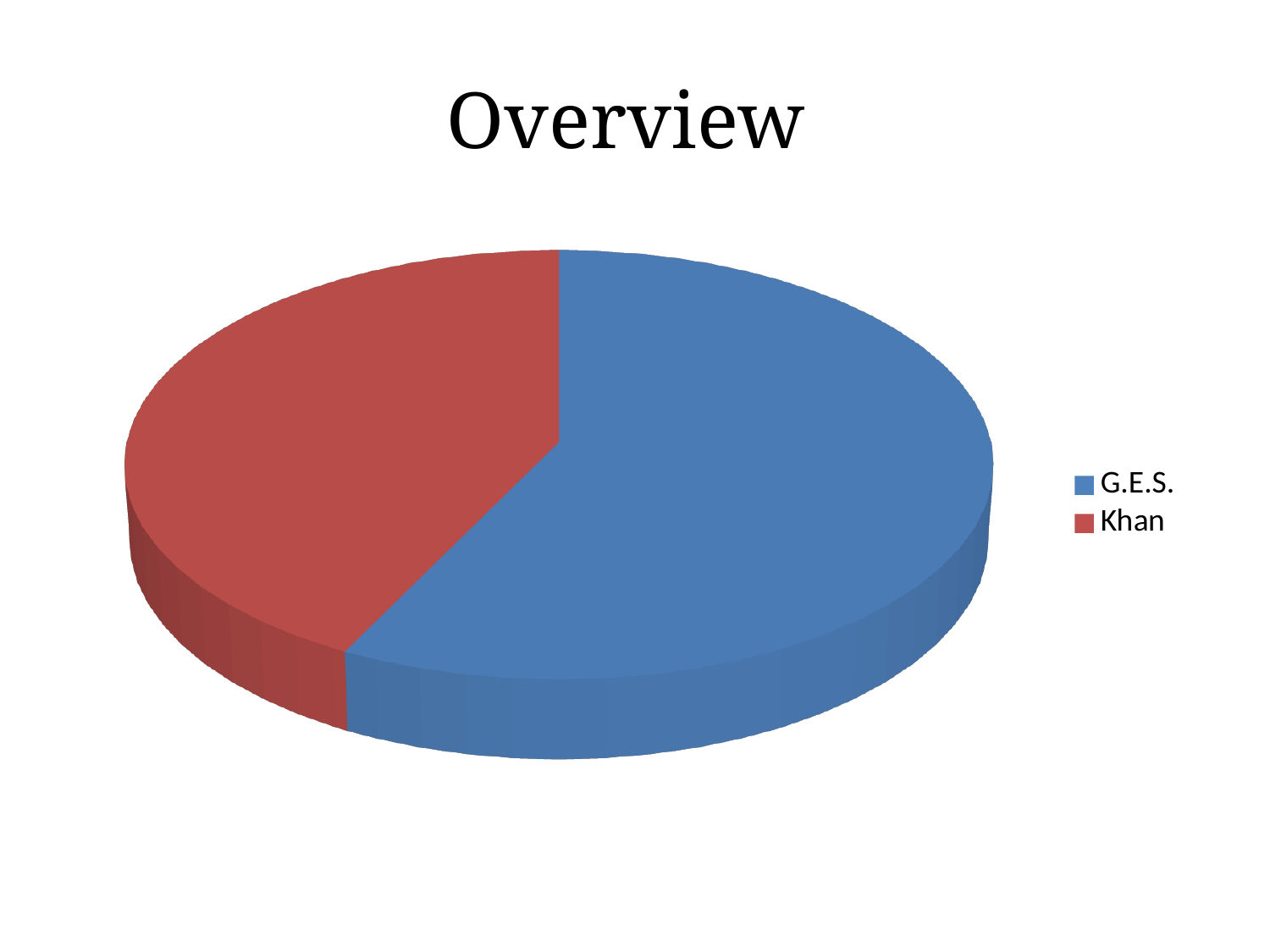
What is the title of the slide containing the pie chart? Overview Which slice is the largest in the pie chart? G.E.S. How many slices does the pie chart have? 2 Which slice is the smallest in the pie chart? Khan What kind of chart is shown on the slide? pie chart How many entries does the legend list? 2 What colour is the G.E.S. slice in the pie chart? blue Which slice is larger, G.E.S. or Khan? G.E.S.